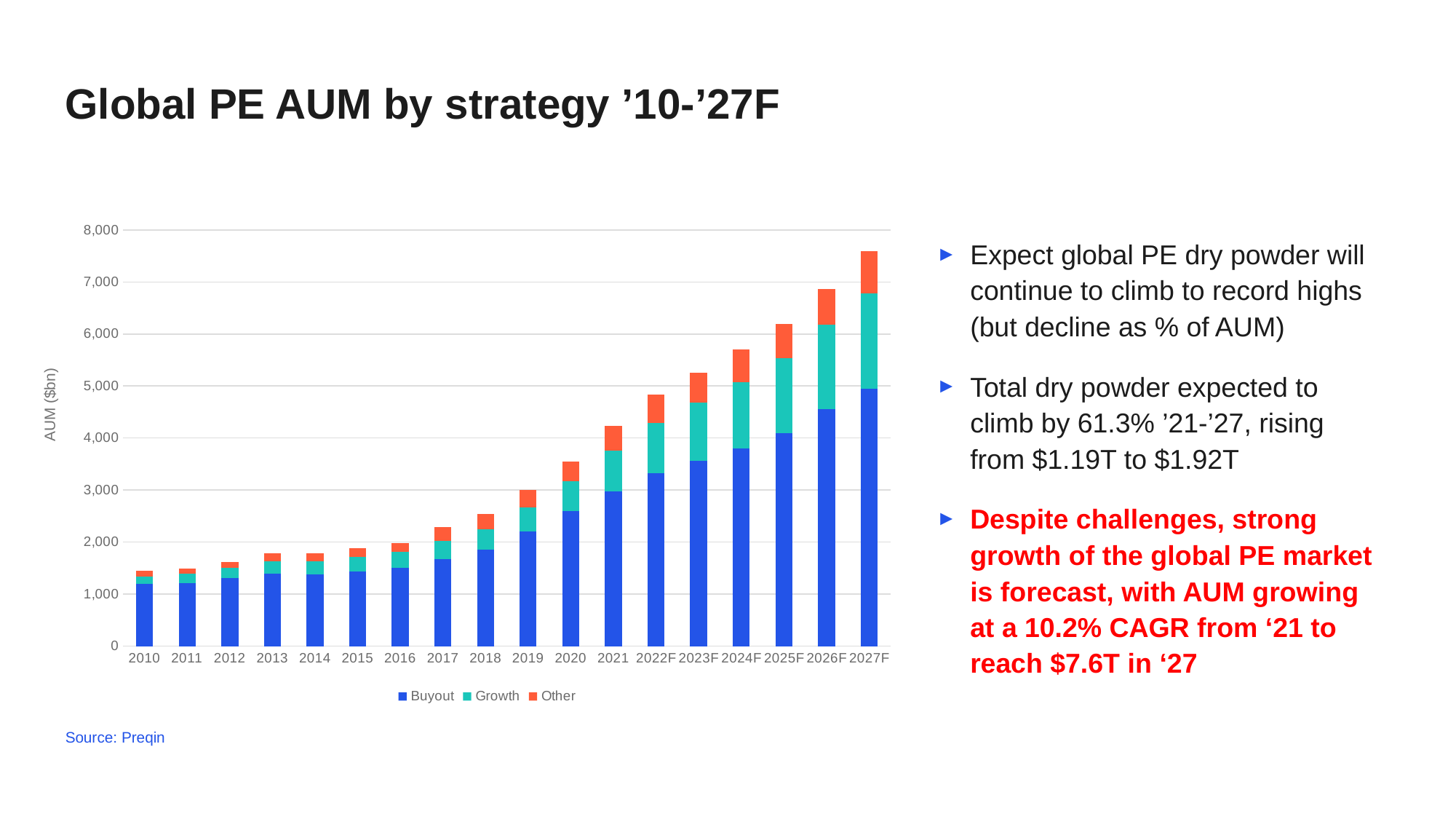
Is the total AUM for 2027F greater or less than 7,000? greater Which year has the larger total AUM, 2020 or 2021? 2021 Is the total AUM for 2010 greater or less than 2,000? less What is the label on the y axis? AUM ($bn) Is the Buyout value for 2027F greater or less than 4,000? greater What kind of chart is shown on the slide? Stacked bar chart How many series does the legend list? 3 Which year has the highest total AUM? 2027F How many years (categories) are shown on the x axis? 18 What is the title of the chart? Global PE AUM by strategy '10-'27F Do total AUM values generally rise or fall from 2010 to 2027F? Rise